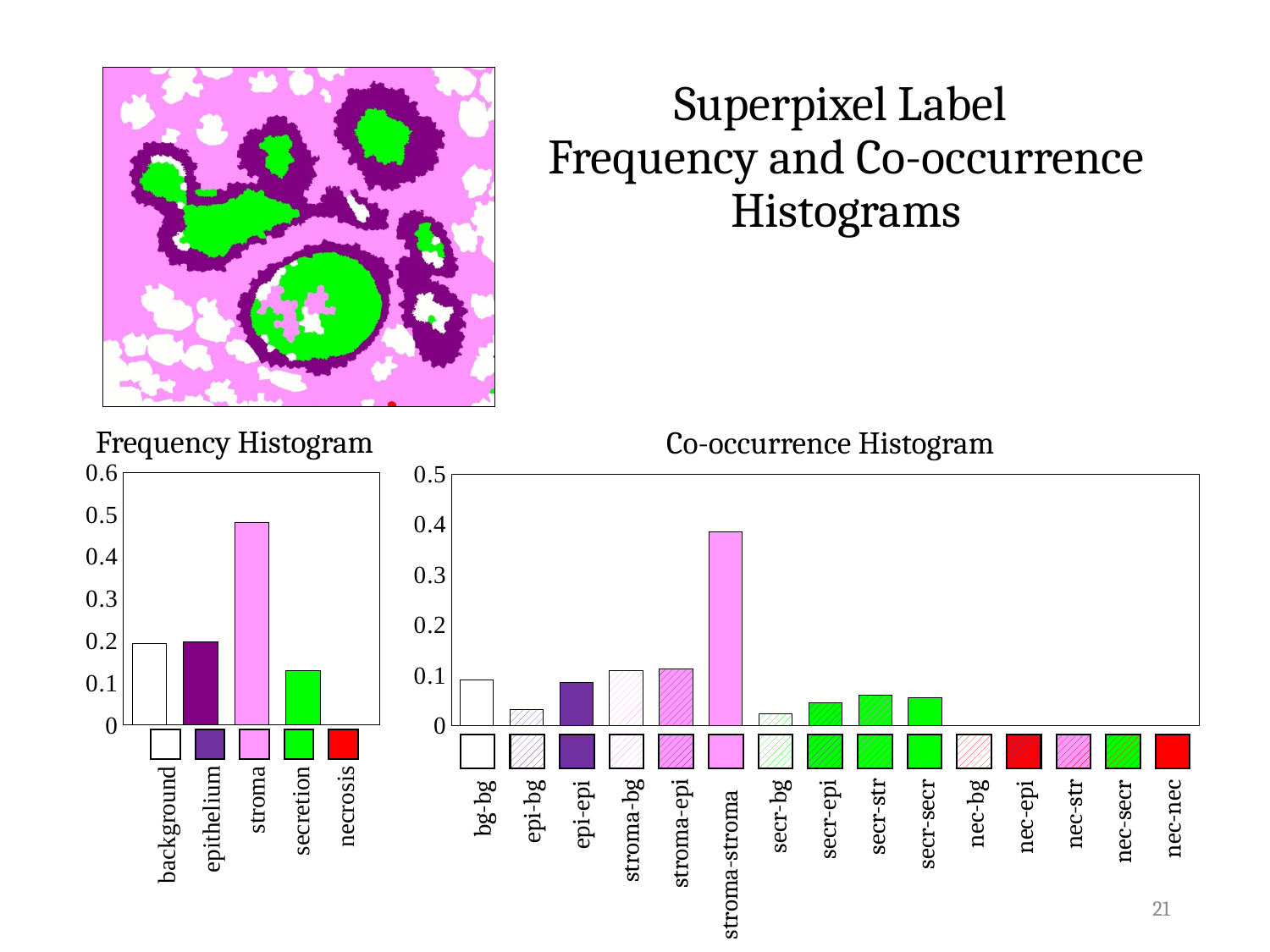
In the Co-occurrence Histogram, is the value for stroma-stroma greater or less than 0.3? greater In the Co-occurrence Histogram, is the value for epi-bg greater or less than 0.1? less How many categories are shown in the Frequency Histogram? 5 What kind of chart is the Co-occurrence Histogram? bar chart In the Frequency Histogram, which is larger, the value for stroma or the value for secretion? stroma In the Co-occurrence Histogram, which category has the highest value? stroma-stroma In the Frequency Histogram, is the value for secretion greater or less than 0.2? less In the Frequency Histogram, which category has the lowest value? necrosis In the Frequency Histogram, which category has the highest value? stroma How many categories are shown in the Co-occurrence Histogram? 15 In the Co-occurrence Histogram, which is larger, the value for bg-bg or the value for epi-bg? bg-bg